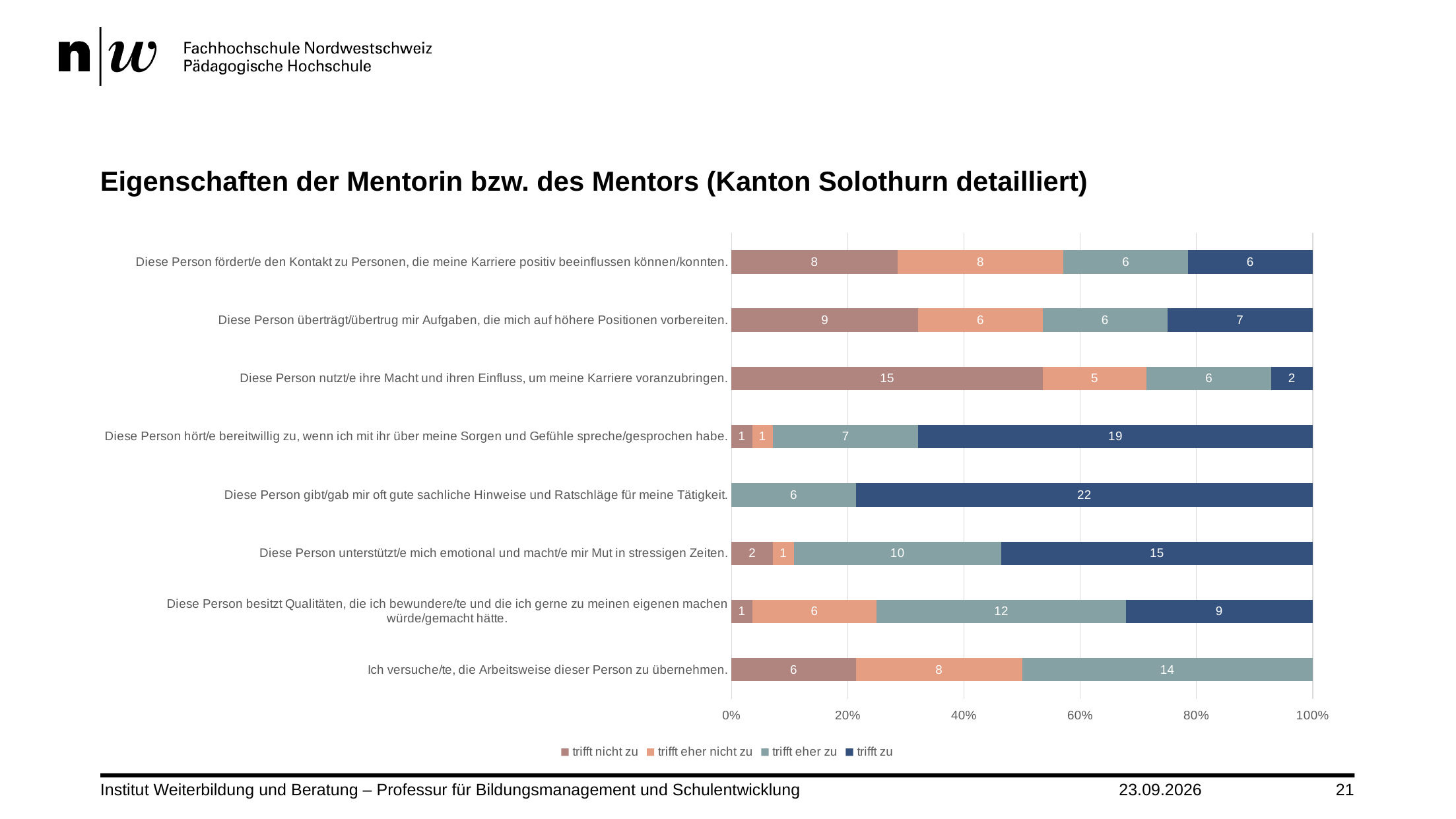
What is the difference between the "trifft zu" values for "Diese Person hört/e bereitwillig zu, wenn ich mit ihr über meine Sorgen und Gefühle spreche/gesprochen habe." and "Diese Person unterstützt/e mich emotional und macht/e mir Mut in stressigen Zeiten."? 4 Which statement has the lowest "trifft zu" value among those with a "trifft zu" label? Diese Person nutzt/e ihre Macht und ihren Einfluss, um meine Karriere voranzubringen. What is the total of all segments in the bar for "Diese Person besitzt Qualitäten, die ich bewundere/te und die ich gerne zu meinen eigenen machen würde/gemacht hätte."? 28 How many statements (categories) are plotted in the chart? 8 What kind of chart is shown on the slide? Stacked bar chart How many series does the legend list? 4 Which is larger: the "trifft nicht zu" value for "Diese Person überträgt/übertrug mir Aufgaben, die mich auf höhere Positionen vorbereiten." or for "Diese Person fördert/e den Kontakt zu Personen, die meine Karriere positiv beeinflussen können/konnten."? Diese Person überträgt/übertrug mir Aufgaben, die mich auf höhere Positionen vorbereiten. Which statement has the highest "trifft zu" value? Diese Person gibt/gab mir oft gute sachliche Hinweise und Ratschläge für meine Tätigkeit. What is the value of "trifft zu" for "Diese Person gibt/gab mir oft gute sachliche Hinweise und Ratschläge für meine Tätigkeit."? 22 What is the value of "trifft nicht zu" for "Diese Person nutzt/e ihre Macht und ihren Einfluss, um meine Karriere voranzubringen."? 15 What is the value of "trifft eher zu" for "Ich versuche/te, die Arbeitsweise dieser Person zu übernehmen."? 14 What is the title of the chart? Eigenschaften der Mentorin bzw. des Mentors (Kanton Solothurn detailliert)